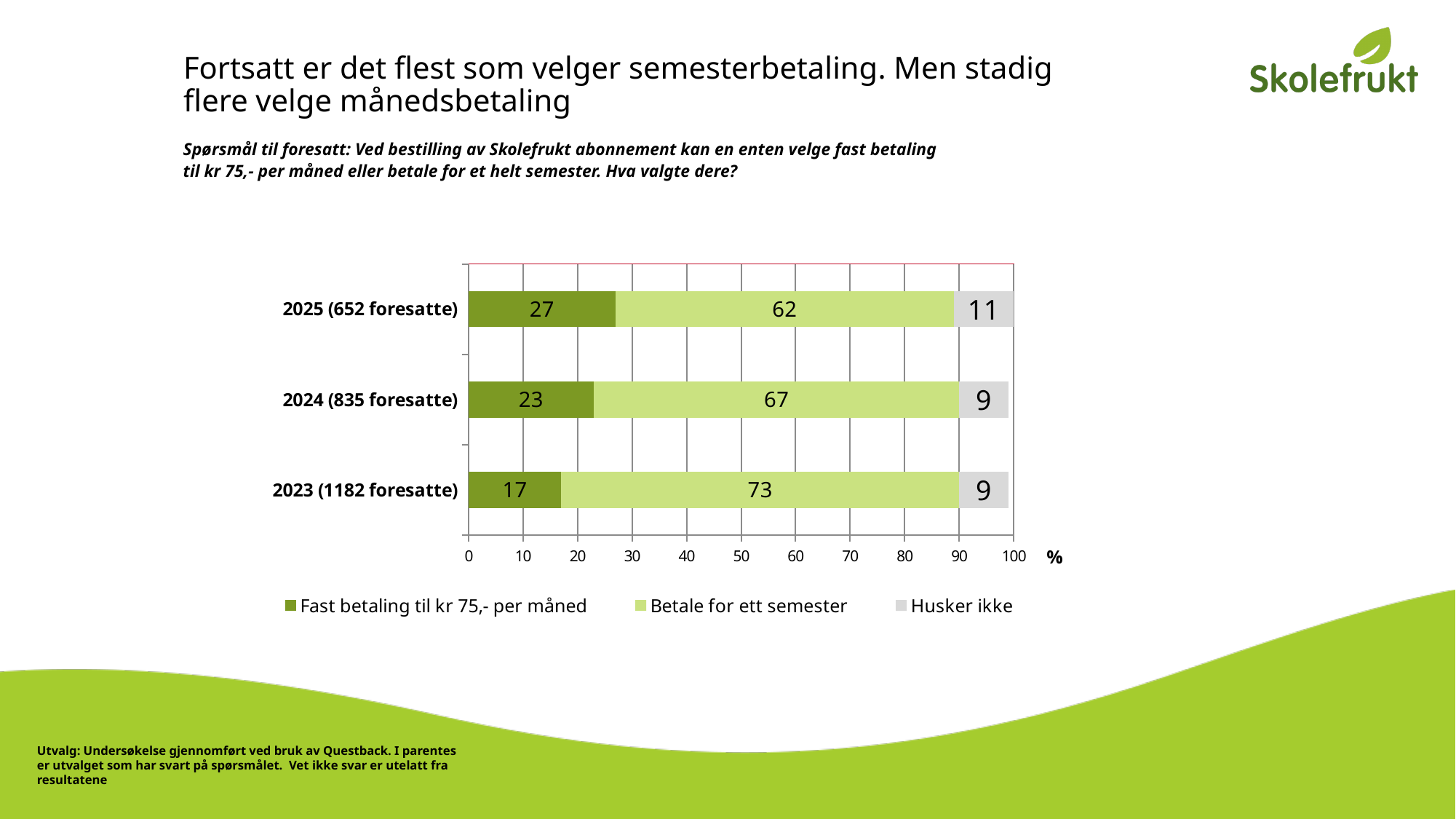
What is the total of the stacked bar for 2025 (652 foresatte)? 100 What is the difference between the 'Betale for ett semester' values for 2023 (1182 foresatte) and 2025 (652 foresatte)? 11 What is the value for 'Betale for ett semester' in 2023 (1182 foresatte)? 73 How many series does the legend list? 3 Which legend entry is shown in grey? Husker ikke How many year categories are shown on the chart? 3 What is the value for 'Fast betaling til kr 75,- per måned' in 2025 (652 foresatte)? 27 Which year has the highest value for 'Betale for ett semester'? 2023 (1182 foresatte) Which year has the lowest value for 'Fast betaling til kr 75,- per måned'? 2023 (1182 foresatte) Which is larger: 'Fast betaling til kr 75,- per måned' in 2024 (835 foresatte) or in 2025 (652 foresatte)? 2025 (652 foresatte) What is the value for 'Husker ikke' in 2024 (835 foresatte)? 9 What kind of chart is shown on the slide? Stacked bar chart